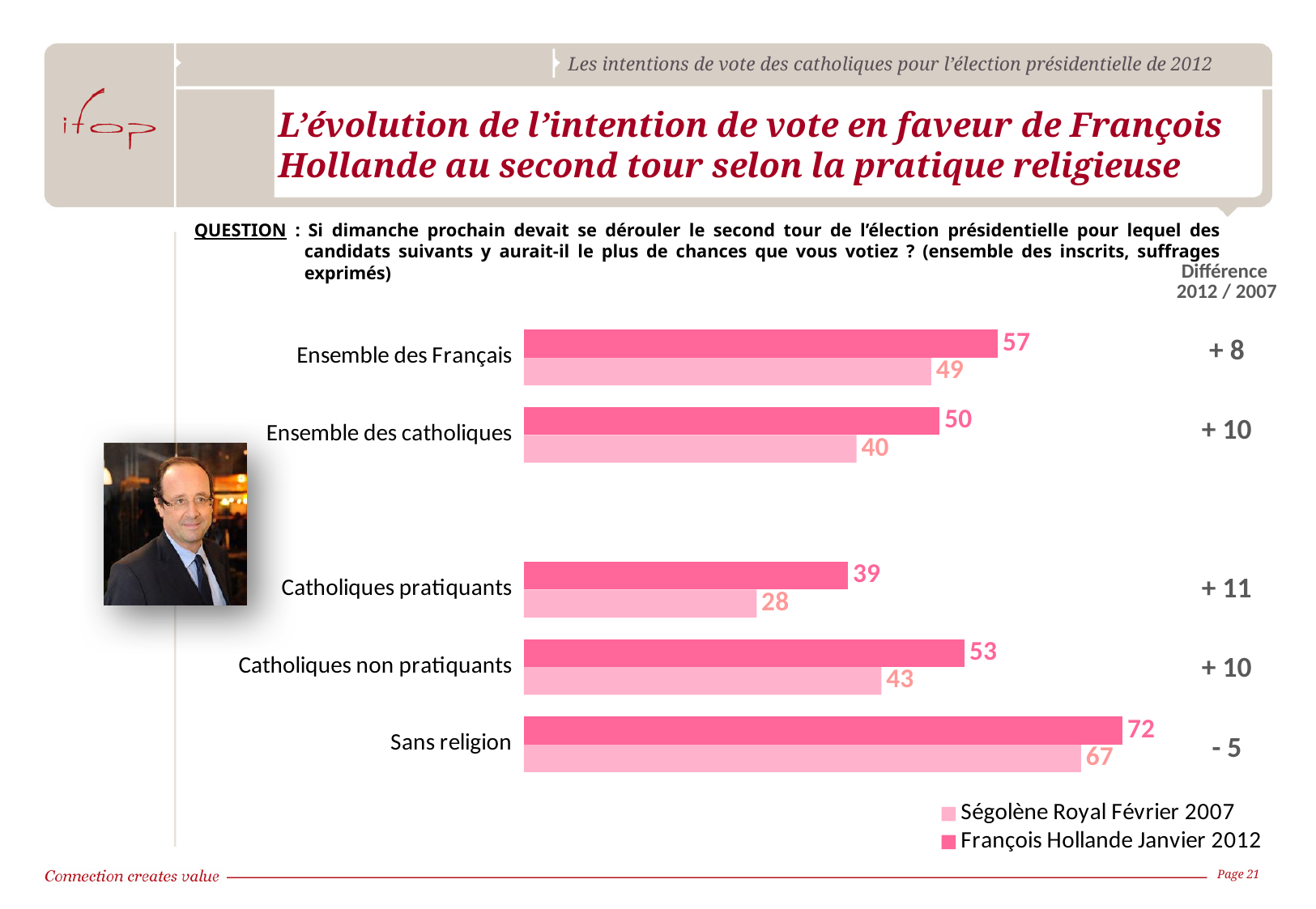
Which is larger for Ensemble des catholiques: the François Hollande Janvier 2012 value or the Ségolène Royal Février 2007 value? François Hollande Janvier 2012 What is the value for François Hollande Janvier 2012 among Ensemble des Français? 57 How many series does the legend list? 2 What is the value for François Hollande Janvier 2012 among Sans religion? 72 How many categories are shown in the chart? 5 What is the difference between the François Hollande Janvier 2012 value and the Ségolène Royal Février 2007 value for Catholiques non pratiquants? 10 What is the value for Ségolène Royal Février 2007 among Catholiques pratiquants? 28 Which category has the lowest value for Ségolène Royal Février 2007? Catholiques pratiquants Which category has the highest value for François Hollande Janvier 2012? Sans religion What is the value for Ségolène Royal Février 2007 among Ensemble des catholiques? 40 What kind of chart is shown on the slide? Bar chart What is the 'Différence 2012 / 2007' shown for Catholiques pratiquants? + 11